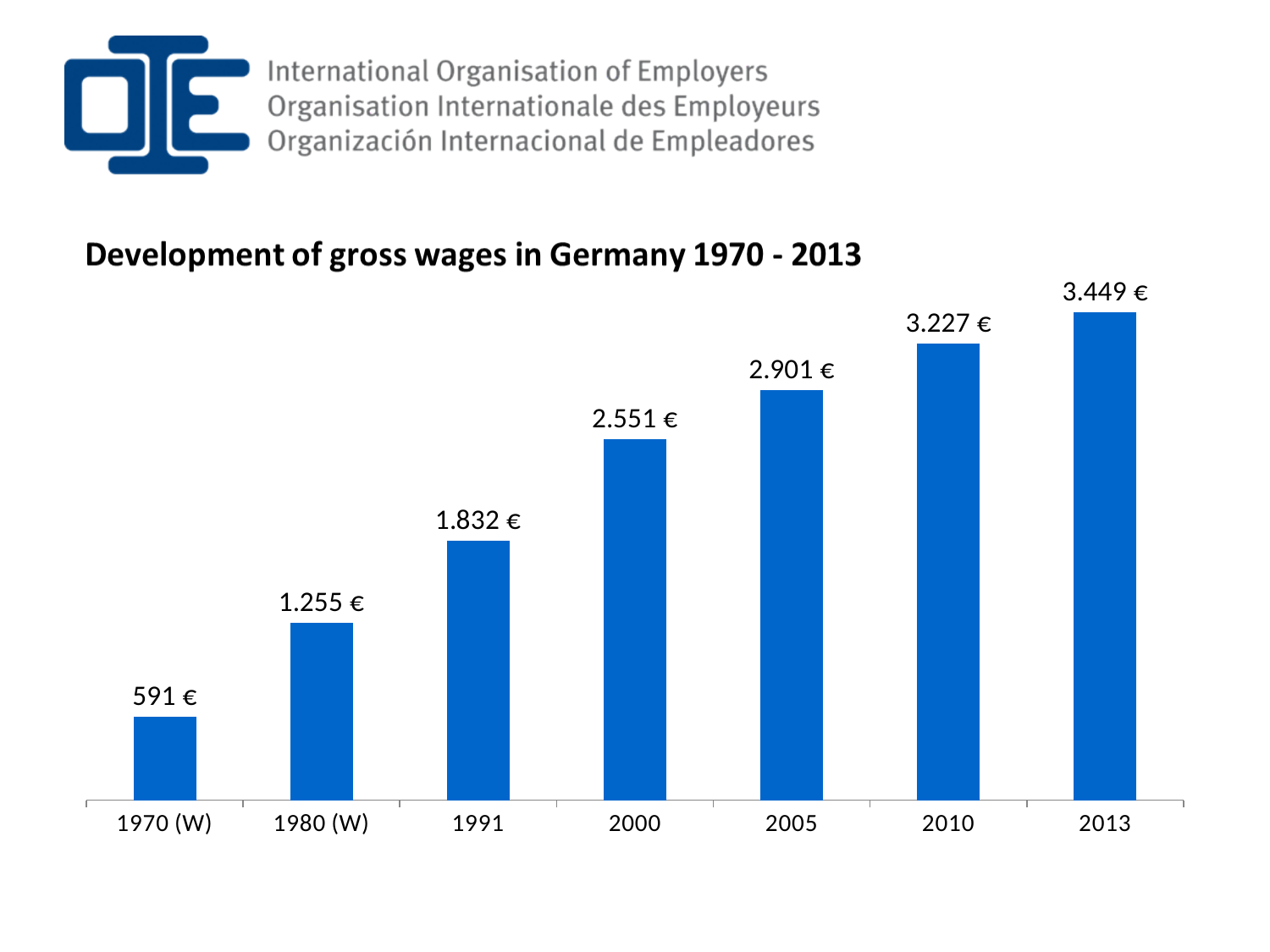
What is the value for 1970 (W)? 591 € Which is larger, the value for 1980 (W) or the value for 2000? 2000 What is the value for 1991? 1.832 € What is the difference between the values for 2013 and 2010? 222 € How many years are shown on the chart? 7 Which year has the lowest value? 1970 (W) Do the values rise or fall from 1970 (W) to 2013? Rise What kind of chart is this? Bar chart What is the title of the chart? Development of gross wages in Germany 1970 - 2013 What is the difference between the values for 2000 and 1991? 719 € What is the value for 2005? 2.901 € Which year has the highest value? 2013